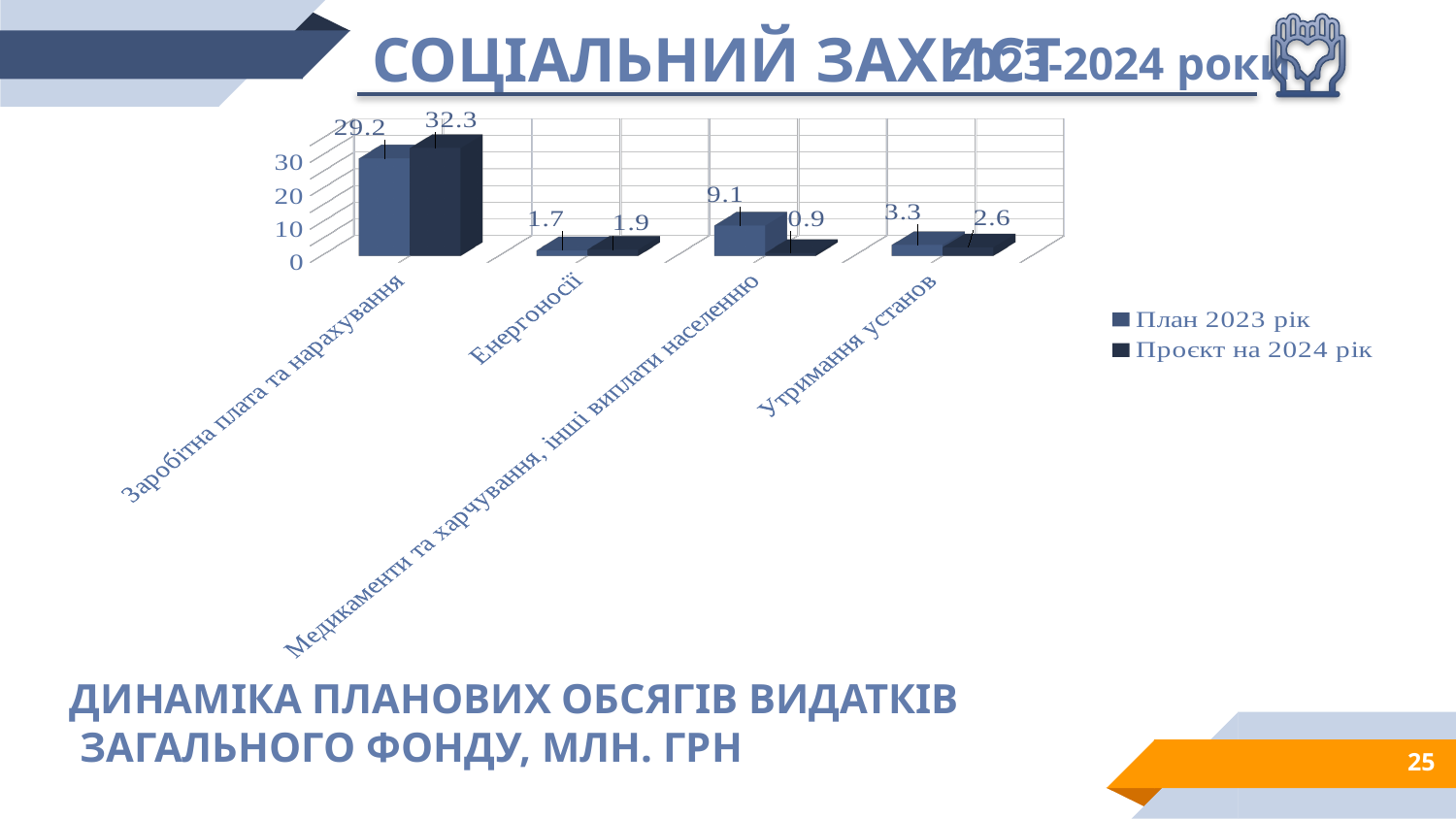
What is the value for "Заробітна плата та нарахування" in the "План 2023 рік" series? 29.2 What is the value for "Медикаменти та харчування, інші виплати населенню" in the "План 2023 рік" series? 9.1 What is the value for "Енергоносії" in the "Проєкт на 2024 рік" series? 1.9 Which category has the lowest value in the "Проєкт на 2024 рік" series? Медикаменти та харчування, інші виплати населенню How many categories are shown on the x axis of the chart? 4 What is the value for "Утримання установ" in the "Проєкт на 2024 рік" series? 2.6 How many series does the chart legend list? 2 What kind of chart is shown on the slide? Bar chart What is the difference between the "Проєкт на 2024 рік" and "План 2023 рік" values for "Заробітна плата та нарахування"? 3.1 For "Утримання установ", which series has the larger value: "План 2023 рік" or "Проєкт на 2024 рік"? План 2023 рік What is the value for "Заробітна плата та нарахування" in the "Проєкт на 2024 рік" series? 32.3 Which category has the highest value in the "План 2023 рік" series? Заробітна плата та нарахування